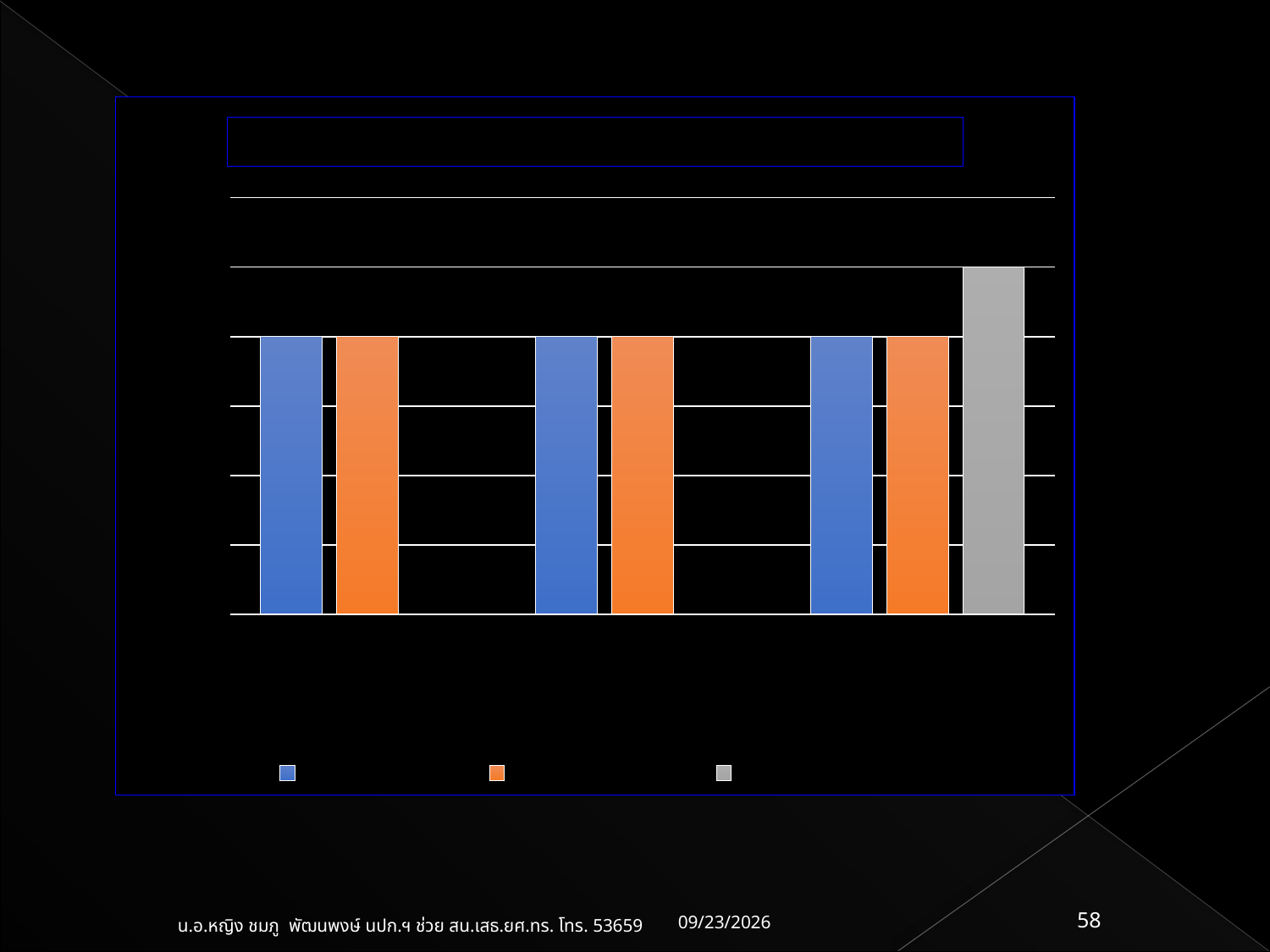
Are the bars in the chart vertical or horizontal? vertical How many groups of bars are plotted along the x axis? 3 Is the grey bar taller or shorter than the blue bars? taller What kind of chart is shown on the slide? bar chart How many series does the legend list? 3 Which colour of bar reaches the highest value on the chart? grey What are the three colours of the series shown in the legend, from left to right? blue, orange, grey